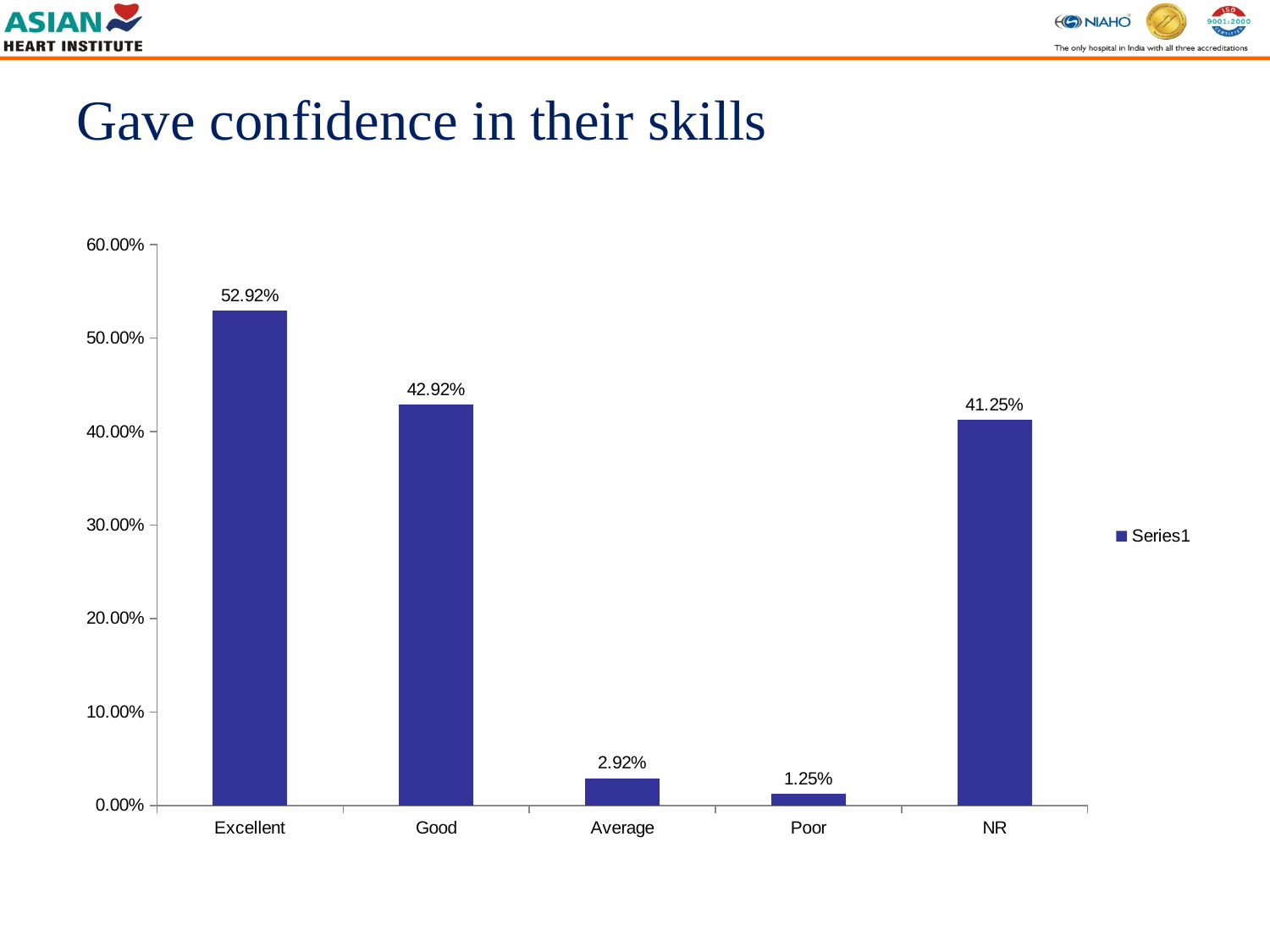
Which is larger, the value for Good or the value for NR? Good What is the difference between the values for Excellent and Good? 10.00% What is the title of the slide containing the chart? Gave confidence in their skills What is the value for Excellent? 52.92% What is the difference between the values for Average and Poor? 1.67% What is the value for NR? 41.25% What kind of chart is shown on the slide? Bar chart What is the value for Poor? 1.25% Which category has the highest value? Excellent What is the value for Good? 42.92% How many categories are shown on the x axis? 5 Which category has the lowest value? Poor